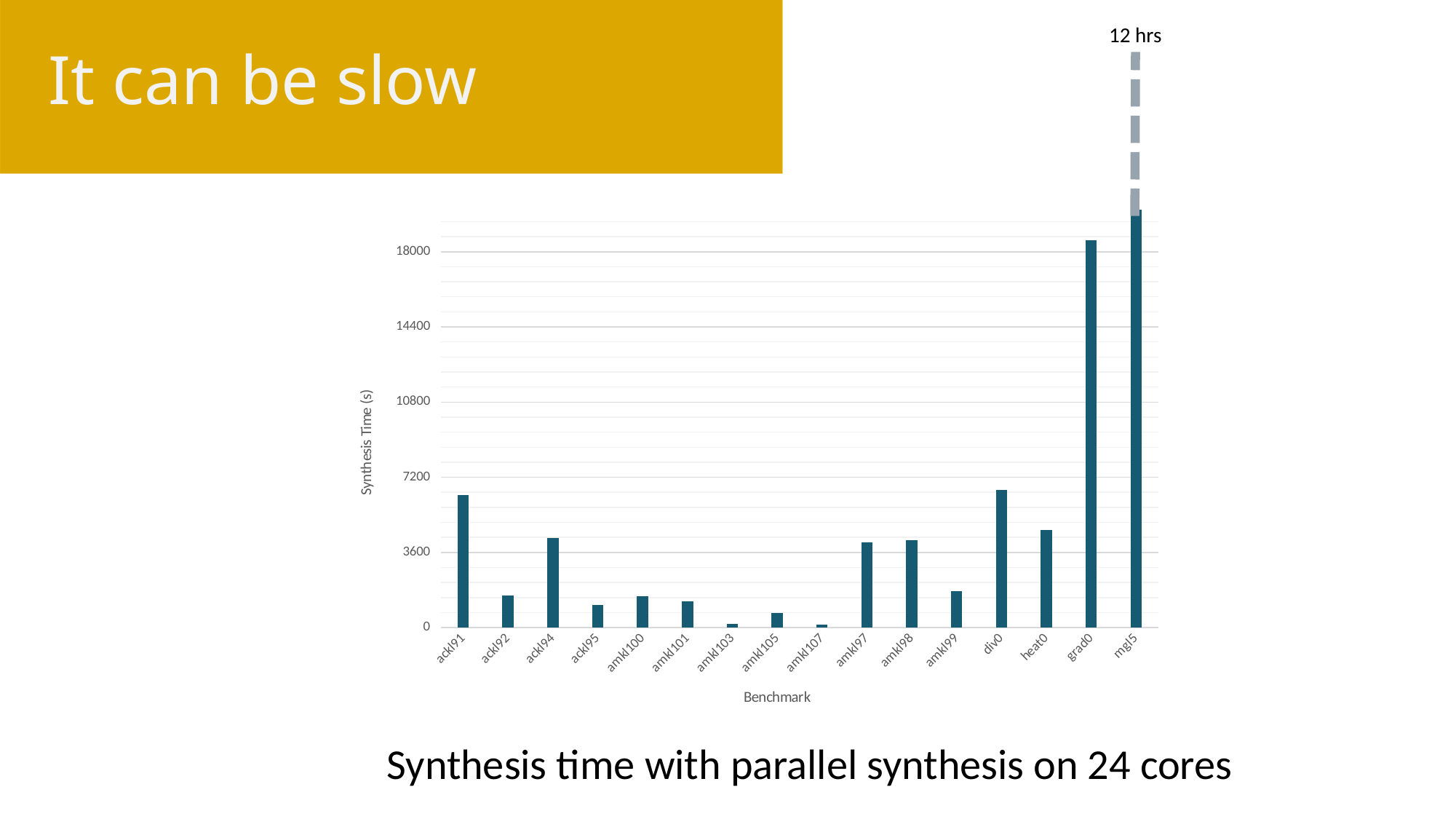
Which has the larger synthesis time, grad0 or mgl5? mgl5 What is the label of the y axis of the chart? Synthesis Time (s) Is the synthesis time for heat0 greater or less than 3600? greater Is the synthesis time for grad0 greater or less than 18000? greater How many benchmarks are plotted on the x axis of the chart? 16 Which benchmark has the highest synthesis time in the chart? mgl5 What kind of chart is shown on the slide? bar chart What is the label of the x axis of the chart? Benchmark Which has the larger synthesis time, ackl91 or ackl94? ackl91 Is the synthesis time for div0 greater or less than 7200? less